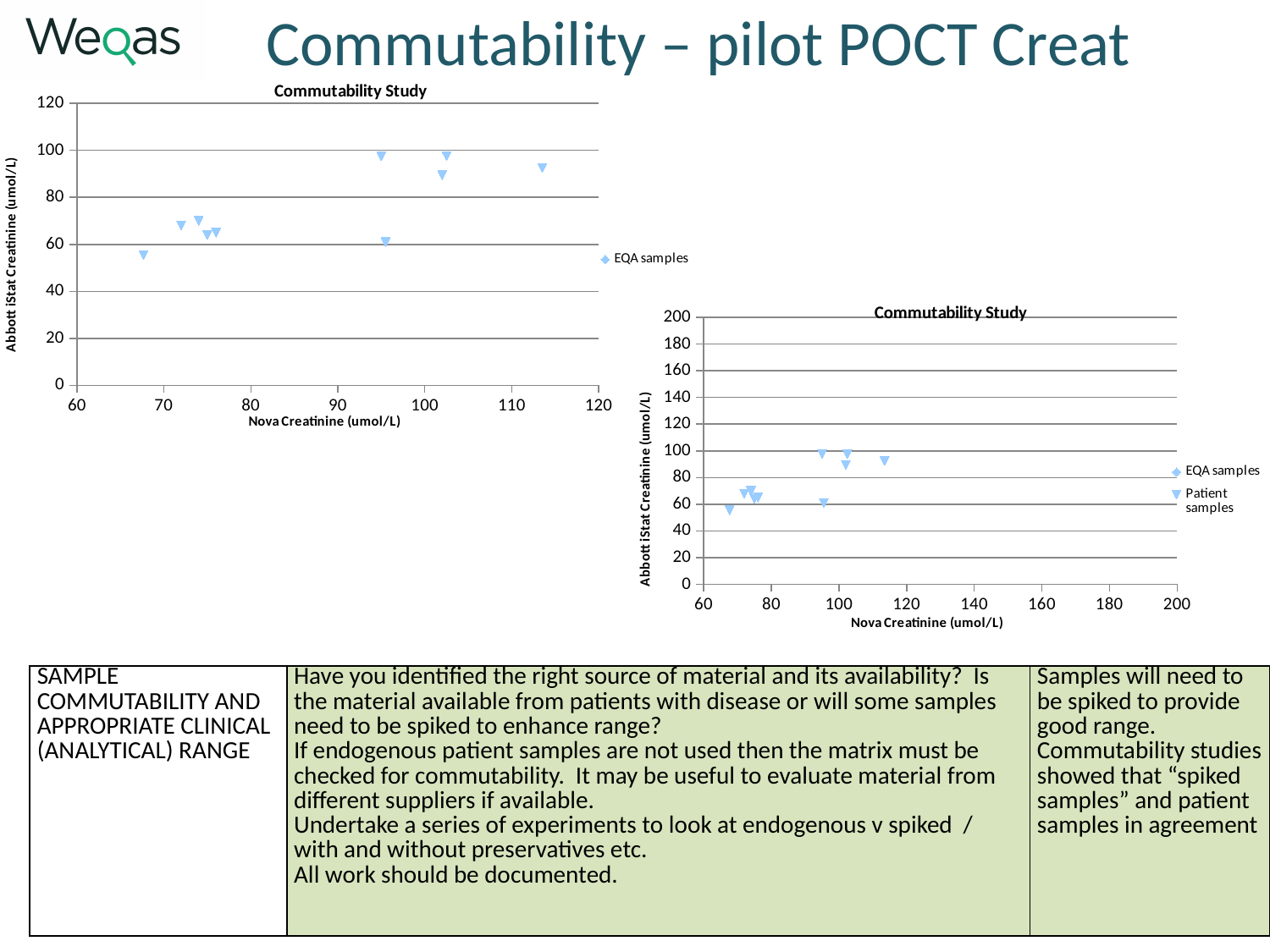
In the chart on the left of the slide, do the Abbott iStat Creatinine values generally rise or fall as Nova Creatinine increases? rise What kind of chart is the chart on the right of the slide? scatter chart What kind of chart is the chart on the left of the slide? scatter chart In the chart on the right of the slide, what are the two legend entries? EQA samples, Patient samples How many series does the legend of the chart on the right of the slide list? 2 In the chart on the right of the slide, do the plotted values generally rise or fall as Nova Creatinine increases? rise In the chart on the right of the slide, is the highest plotted Abbott iStat Creatinine value greater or less than 120? less In the chart on the left of the slide, is the lowest plotted Abbott iStat Creatinine value greater or less than 40? greater In the chart on the right of the slide, is the largest Nova Creatinine value of any plotted point greater or less than 140? less What is the title of the chart on the left of the slide? Commutability Study How many series does the legend of the chart on the left of the slide list? 1